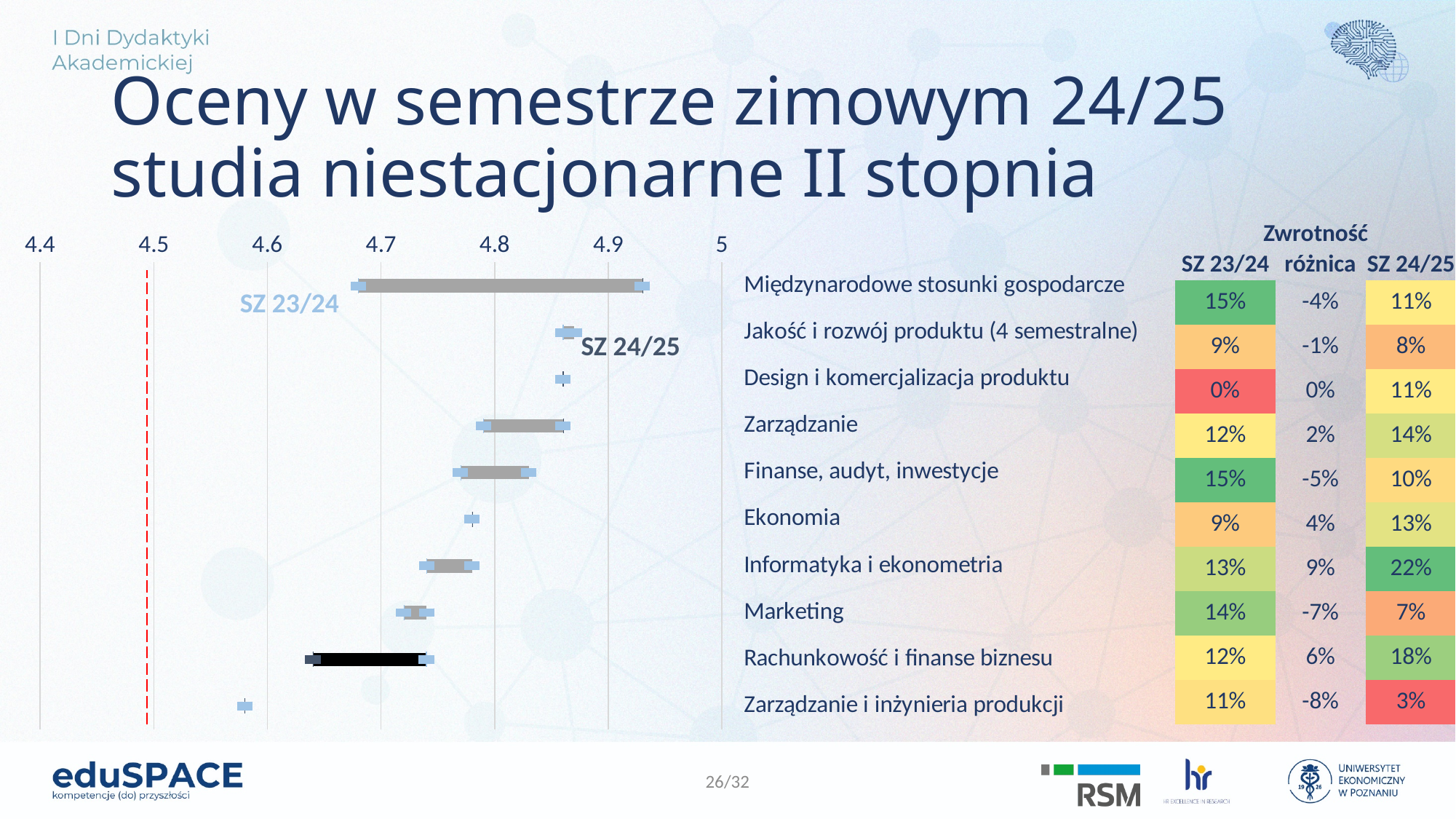
Is the SZ 24/25 grade for Międzynarodowe stosunki gospodarcze greater or less than 4.9? greater At which x-axis value is the red dashed vertical line drawn? 4.5 Is the SZ 24/25 grade for Rachunkowość i finanse biznesu greater or less than 4.7? less For Międzynarodowe stosunki gospodarcze, which semester has the higher grade, SZ 23/24 or SZ 24/25? SZ 24/25 How many study programmes (categories) are plotted on the chart? 10 Is the grade for Jakość i rozwój produktu (4 semestralne) greater or less than 4.8? greater For Rachunkowość i finanse biznesu, which semester has the higher grade, SZ 23/24 or SZ 24/25? SZ 23/24 What kind of chart is used to show the grades? dumbbell (range) chart Which programme has the lowest plotted grade on the chart? Zarządzanie i inżynieria produkcji Which programme has the highest SZ 24/25 grade on the chart? Międzynarodowe stosunki gospodarcze Which two semesters (series) does the chart compare? SZ 23/24 and SZ 24/25